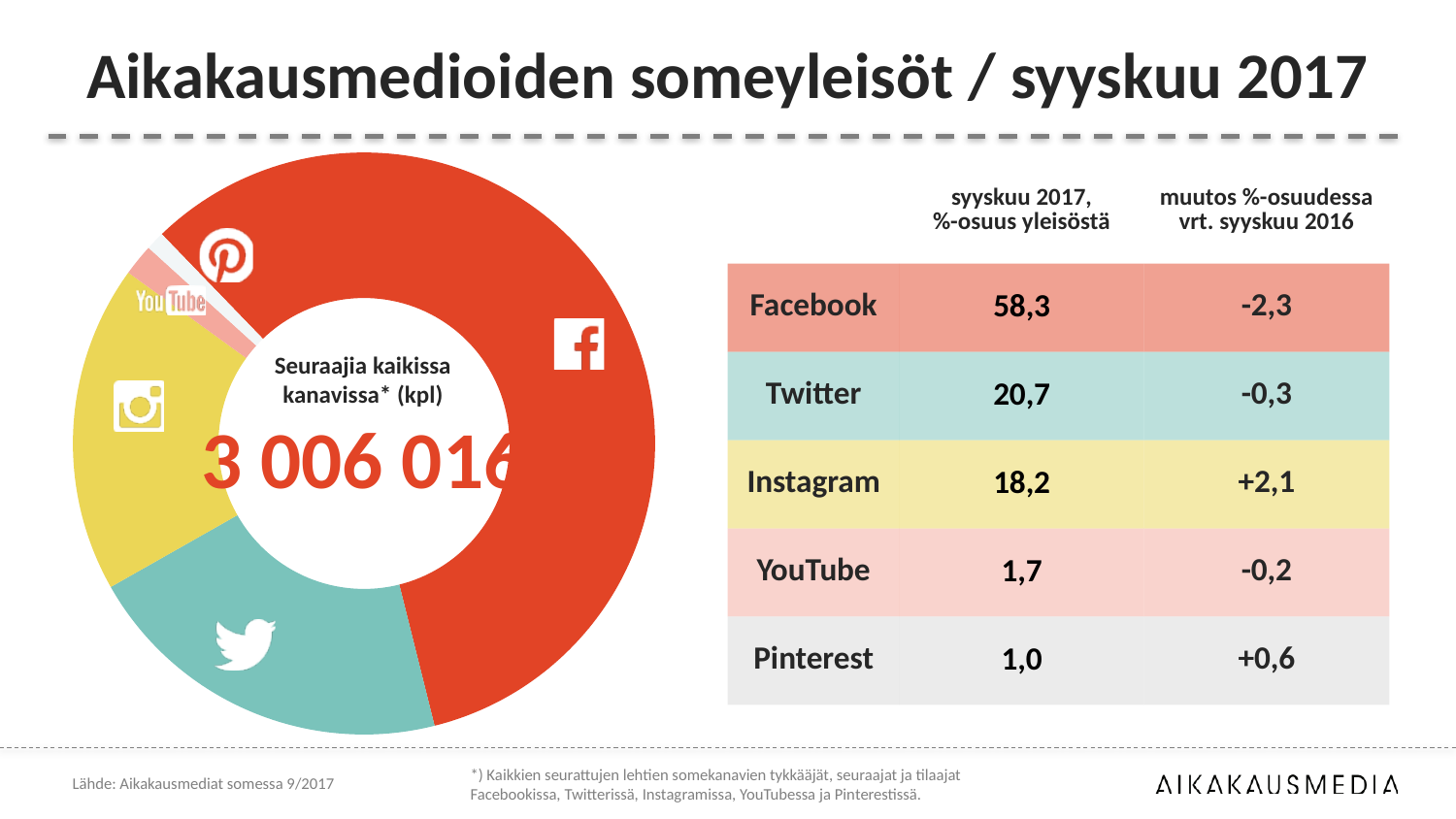
Which channel had the largest positive change in %-share compared with September 2016? Instagram According to the slide, what is Instagram's %-share of the audience in September 2017? 18,2 What kind of chart is shown on the left of the slide? Donut (pie) chart What colour is the Facebook slice in the donut chart? Red What is the difference in %-share between Facebook (58,3) and Twitter (20,7)? 37,6 Which channel has the largest slice in the donut chart? Facebook What is the change in Twitter's %-share compared with September 2016? -0,3 Which channel has the smallest slice in the donut chart? Pinterest How many social media channels are shown as slices in the donut chart? 5 According to the slide, what is Facebook's %-share of the audience in September 2017? 58,3 Which slice is larger in the donut chart, Twitter or Instagram? Twitter What total number of followers across all channels is printed in the centre of the donut chart? 3 006 016